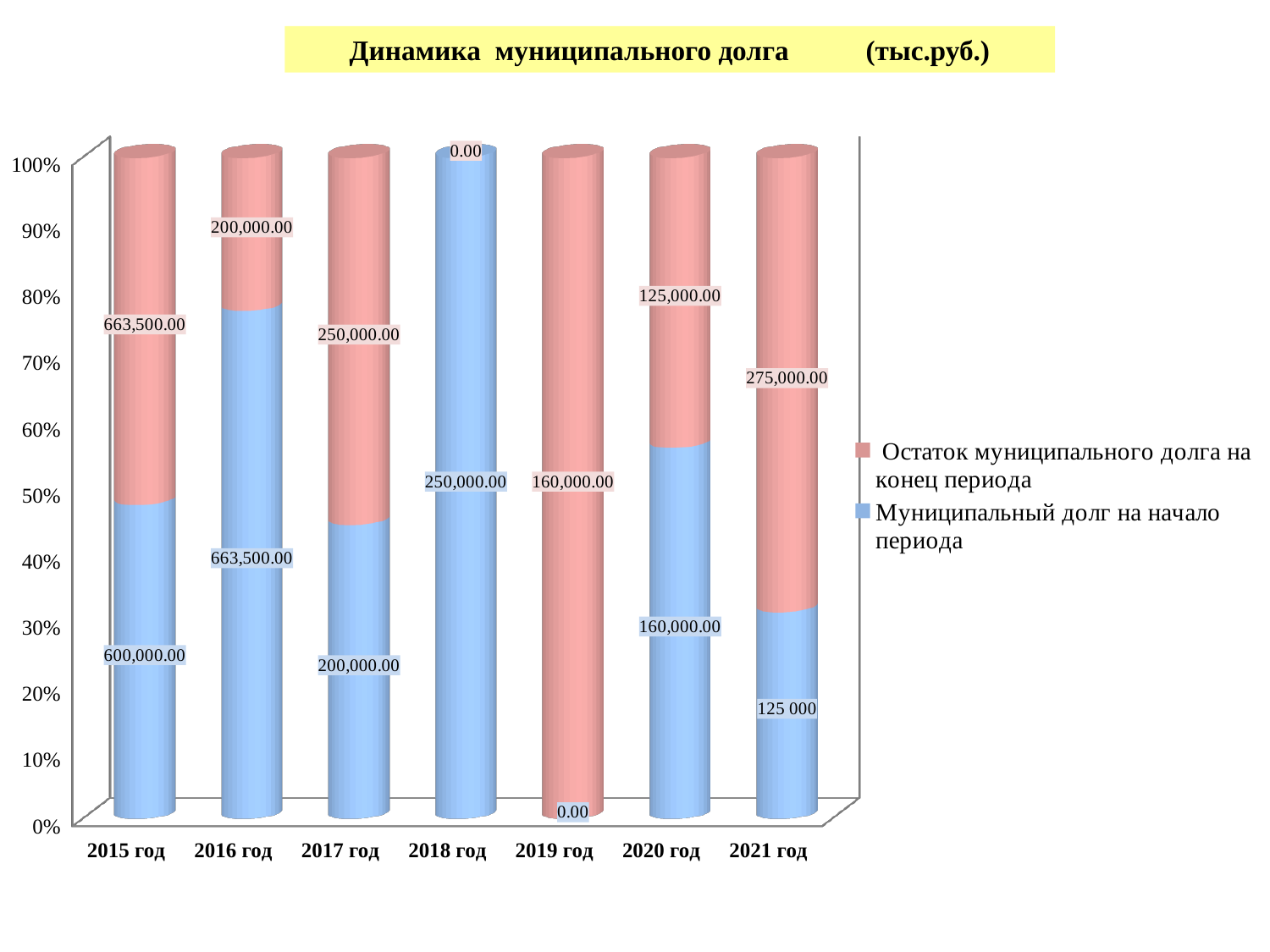
Which is larger for 2016 год: 'Муниципальный долг на начало периода' or 'Остаток муниципального долга на конец периода'? Муниципальный долг на начало периода How many series does the legend list? 2 In which year is 'Муниципальный долг на начало периода' the lowest? 2019 год How many years are shown on the x axis? 7 What is the difference between 'Остаток муниципального долга на конец периода' and 'Муниципальный долг на начало периода' for 2021 год? 150,000.00 What is the value of 'Остаток муниципального долга на конец периода' for 2018 год? 0.00 In which year is 'Остаток муниципального долга на конец периода' the highest? 2015 год What is the value of 'Муниципальный долг на начало периода' for 2020 год? 160,000.00 What is the value of 'Остаток муниципального долга на конец периода' for 2021 год? 275,000.00 What is the value of 'Муниципальный долг на начало периода' for 2015 год? 600,000.00 What kind of chart is shown on the slide? Stacked bar chart What is the title of the chart? Динамика муниципального долга (тыс.руб.)